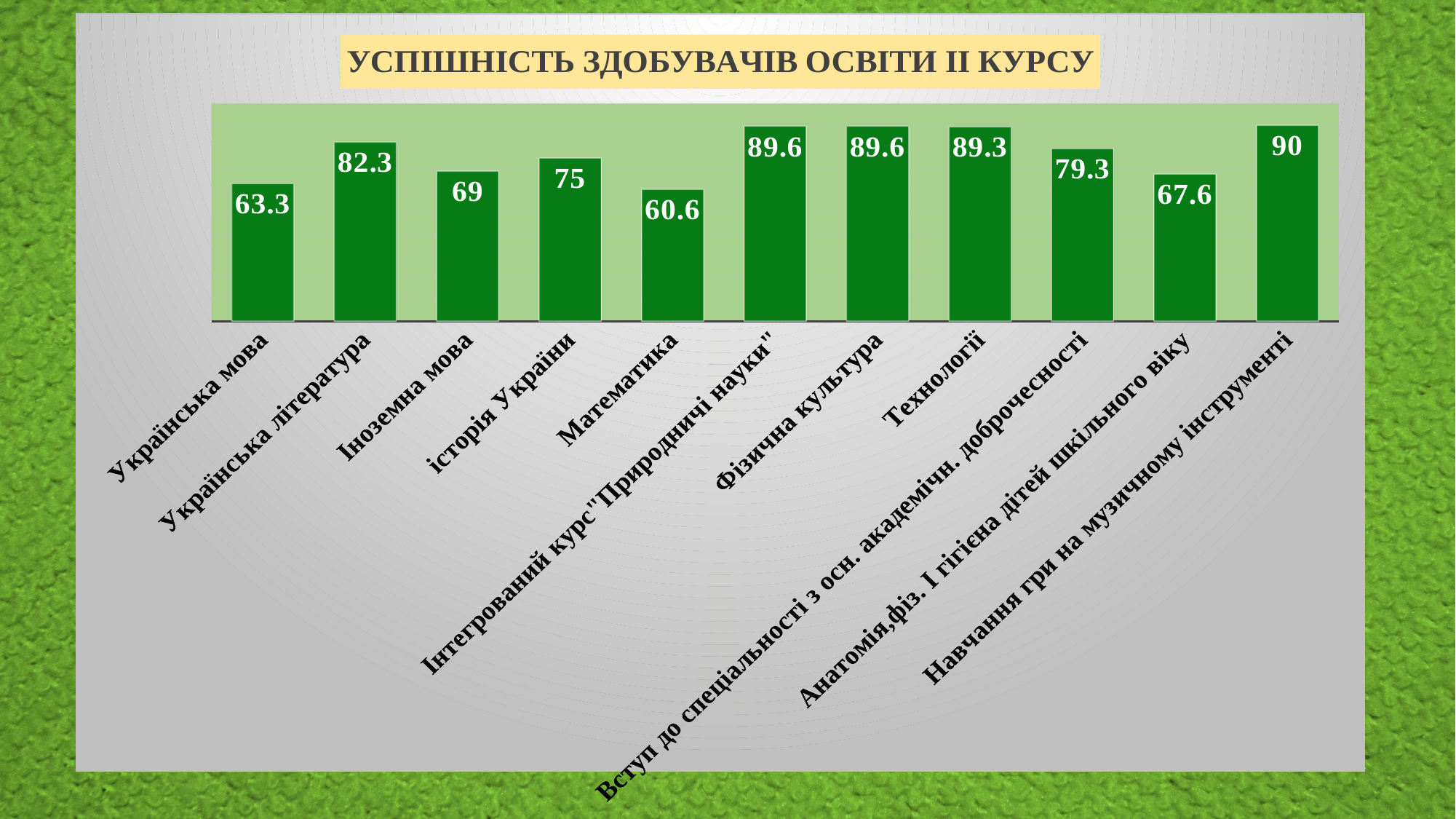
Which category has the highest value? Навчання гри на музичному інструменті What is the value for Українська література? 82.3 What kind of chart is shown on the slide? Bar chart What is the difference between the values for Українська література and Українська мова? 19 What is the value for Математика? 60.6 Which category has the lowest value? Математика Which is larger, the value for Іноземна мова or the value for історія України? історія України What is the value for Вступ до спеціальності з осн. академічн. доброчесності? 79.3 What is the title of the chart? УСПІШНІСТЬ ЗДОБУВАЧІВ ОСВІТИ ІІ КУРСУ What is the difference between the values for Навчання гри на музичному інструменті and Математика? 29.4 What is the value for Технології? 89.3 How many categories are shown in the chart? 11